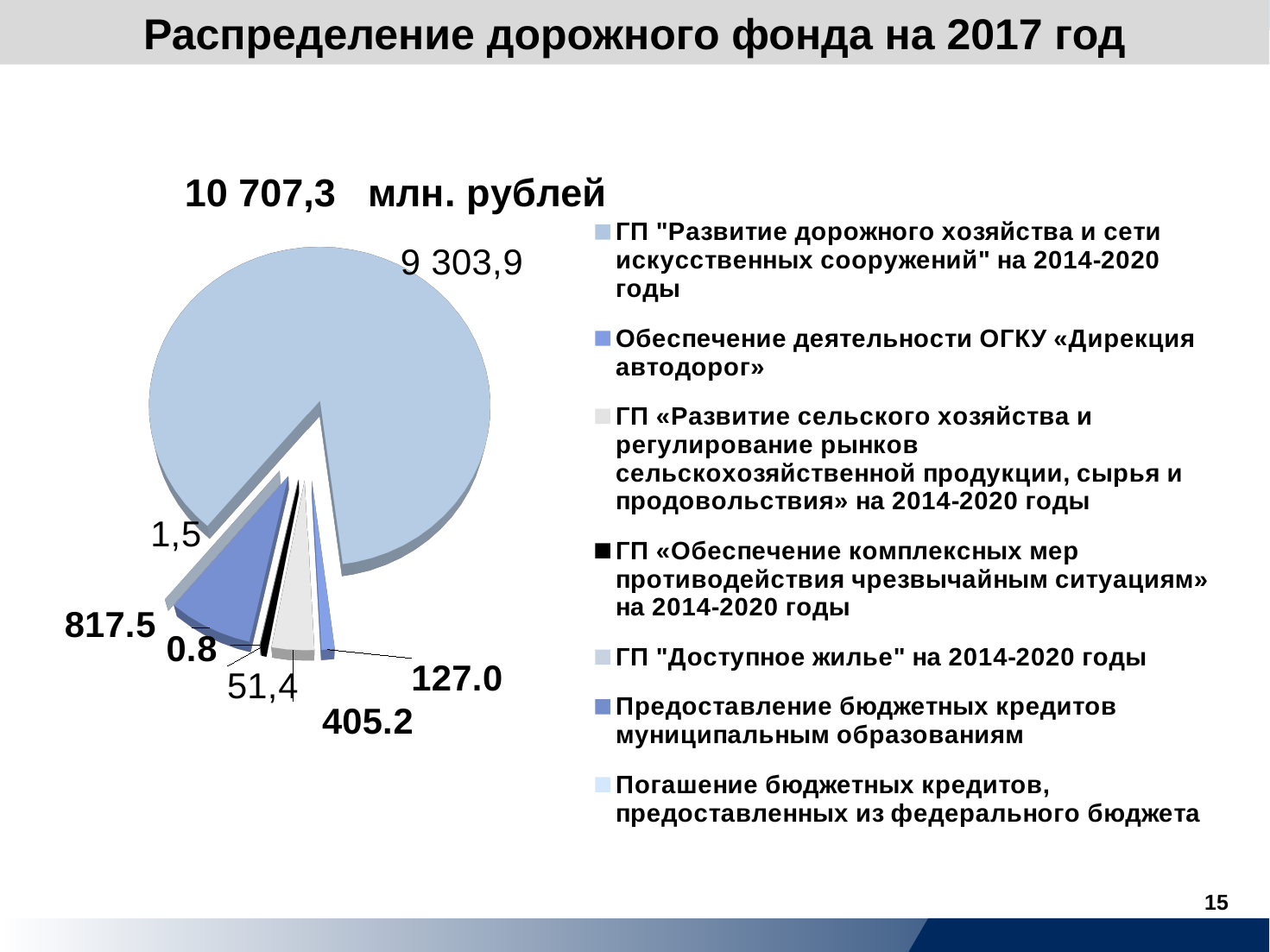
What is the title of the slide containing the chart? Распределение дорожного фонда на 2017 год What total amount is stated above the pie chart? 10 707,3 млн. рублей What is the value of the smallest slice of the pie chart? 0.8 Which is larger, the slice labelled 817.5 or the slice labelled 405.2? 817.5 How many entries does the legend list? 7 What is the value of the largest slice of the pie chart? 9 303,9 What is the difference between the slices labelled 405.2 and 127.0? 278.2 What type of chart is shown on the slide? pie chart What is the difference between the slices labelled 817.5 and 405.2? 412.3 What is the value for ГП «Обеспечение комплексных мер противодействия чрезвычайным ситуациям» на 2014-2020 годы? 51,4 How many slices does the pie chart have? 7 What is the value for ГП "Развитие дорожного хозяйства и сети искусственных сооружений" на 2014-2020 годы? 9 303,9